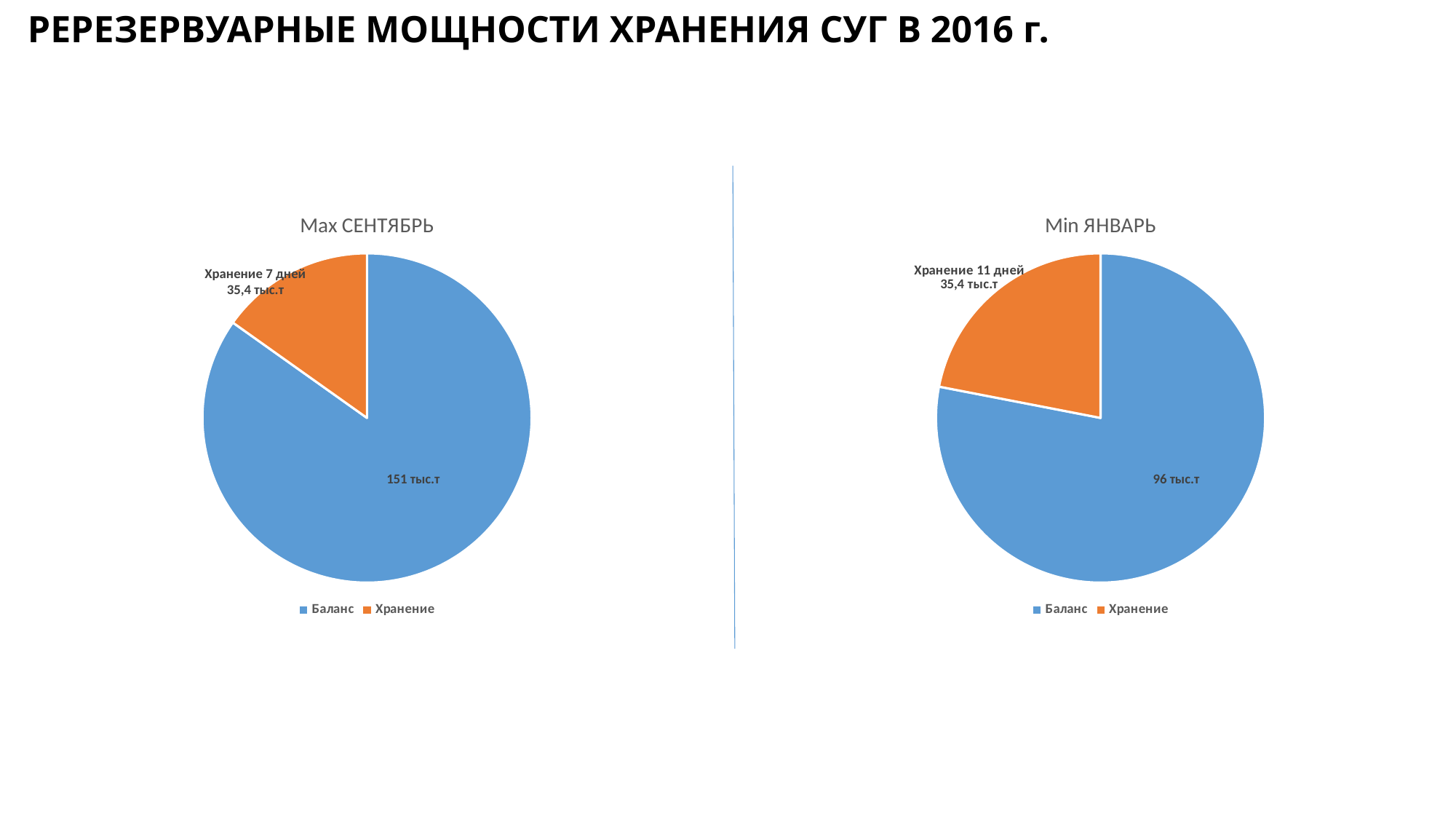
In the "Max СЕНТЯБРЬ" chart, what is the value of the Баланс slice? 151 тыс.т In the "Max СЕНТЯБРЬ" chart, which slice is the largest? Баланс How many entries does the legend of the "Max СЕНТЯБРЬ" chart list? 2 Which chart has the larger Баланс value, "Max СЕНТЯБРЬ" or "Min ЯНВАРЬ"? Max СЕНТЯБРЬ In the "Min ЯНВАРЬ" chart, what is the value of the Баланс slice? 96 тыс.т In the "Max СЕНТЯБРЬ" chart, how many days of storage does the Хранение slice label indicate? 7 дней How many slices does the "Min ЯНВАРЬ" pie chart have? 2 In the "Max СЕНТЯБРЬ" chart, what is the value of the Хранение slice? 35,4 тыс.т In the "Min ЯНВАРЬ" chart, how many days of storage does the Хранение slice label indicate? 11 дней In the "Min ЯНВАРЬ" chart, which slice is the smallest? Хранение In the "Max СЕНТЯБРЬ" chart, what is the difference between the Баланс and Хранение values? 115,6 тыс.т What type of chart is the "Max СЕНТЯБРЬ" chart? pie chart